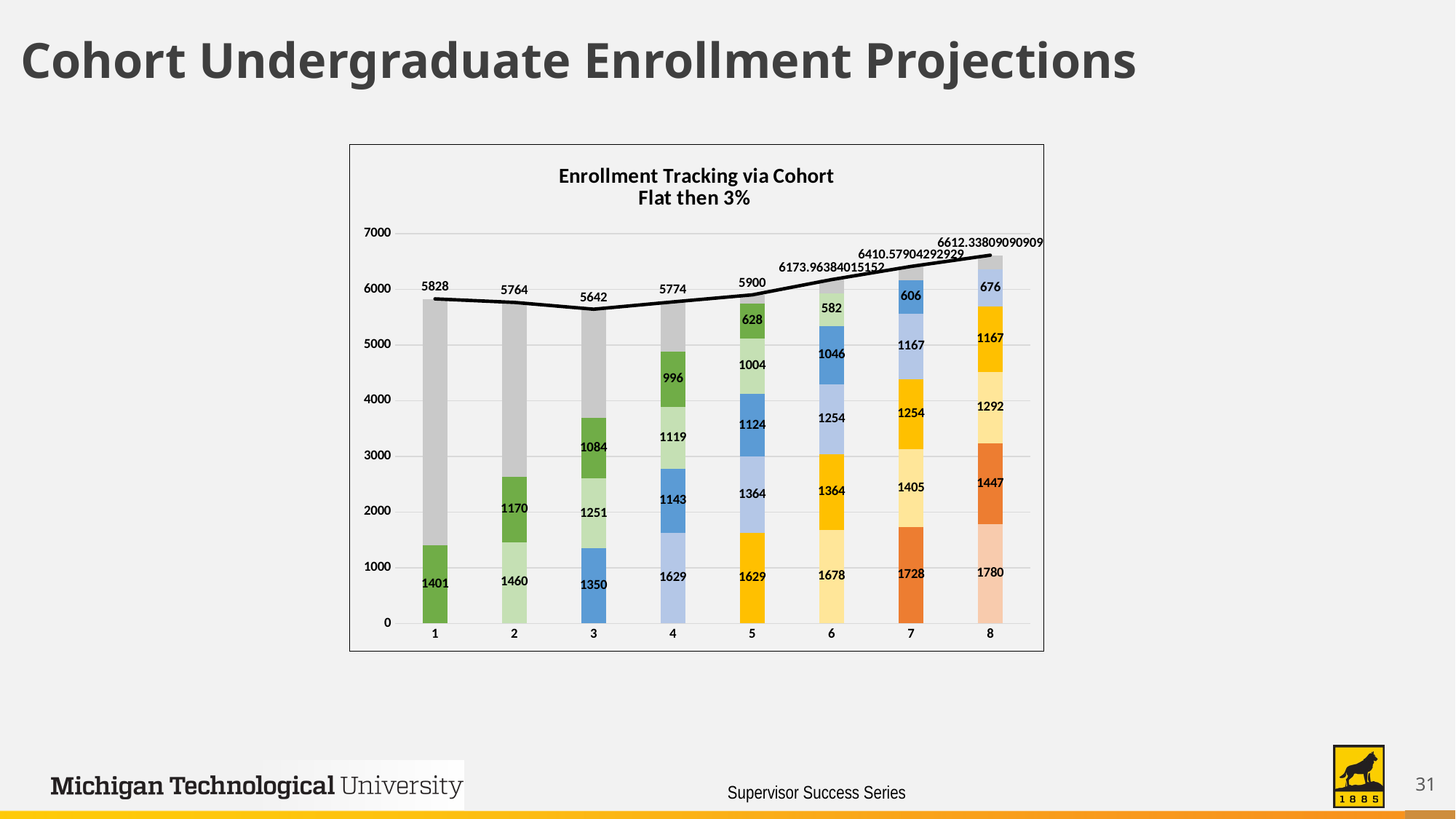
What is the value of the line at category 3? 5642 What is the value of the line at category 8? 6612.33809090909 What is the value of the bottom segment of the bar for category 8? 1780 What is the difference between the line values at category 1 and category 2? 64 What is the value of the line at category 1? 5828 What is the value of the topmost labeled segment of the bar for category 6? 582 At which category is the line at its highest value? 8 Which is larger, the bottom segment of the bar for category 8 or the bottom segment of the bar for category 1? Category 8 What kind of chart is shown on the slide? Stacked bar chart with a line At which category is the line at its lowest value? 3 Does the line rise or fall from category 5 to category 8? Rises How many categories are shown on the x axis of the chart? 8